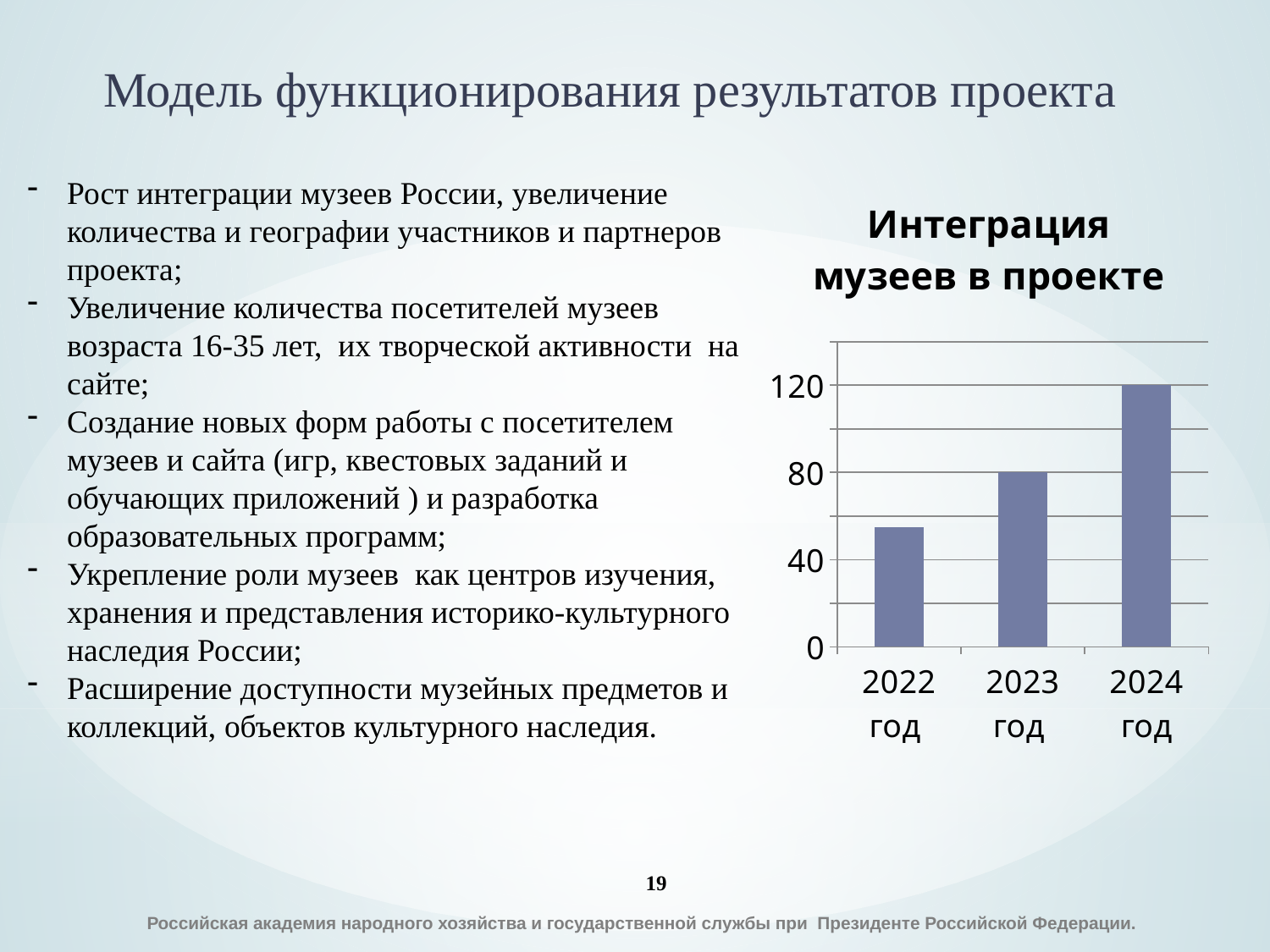
What is the value for 2024 год? 120 Is the value for 2022 год greater or less than 40? greater Which year has the lowest value? 2022 год Which is larger, the value for 2023 год or the value for 2022 год? 2023 год Which year has the highest value? 2024 год What type of chart is shown on the slide? bar chart How many categories (years) are shown on the x axis of the chart? 3 Do the values rise or fall from 2022 год to 2024 год? rise What is the value for 2023 год? 80 What is the title of the chart? Интеграция музеев в проекте What is the difference between the values for 2024 год and 2023 год? 40 Is the value for 2022 год greater or less than 80? less